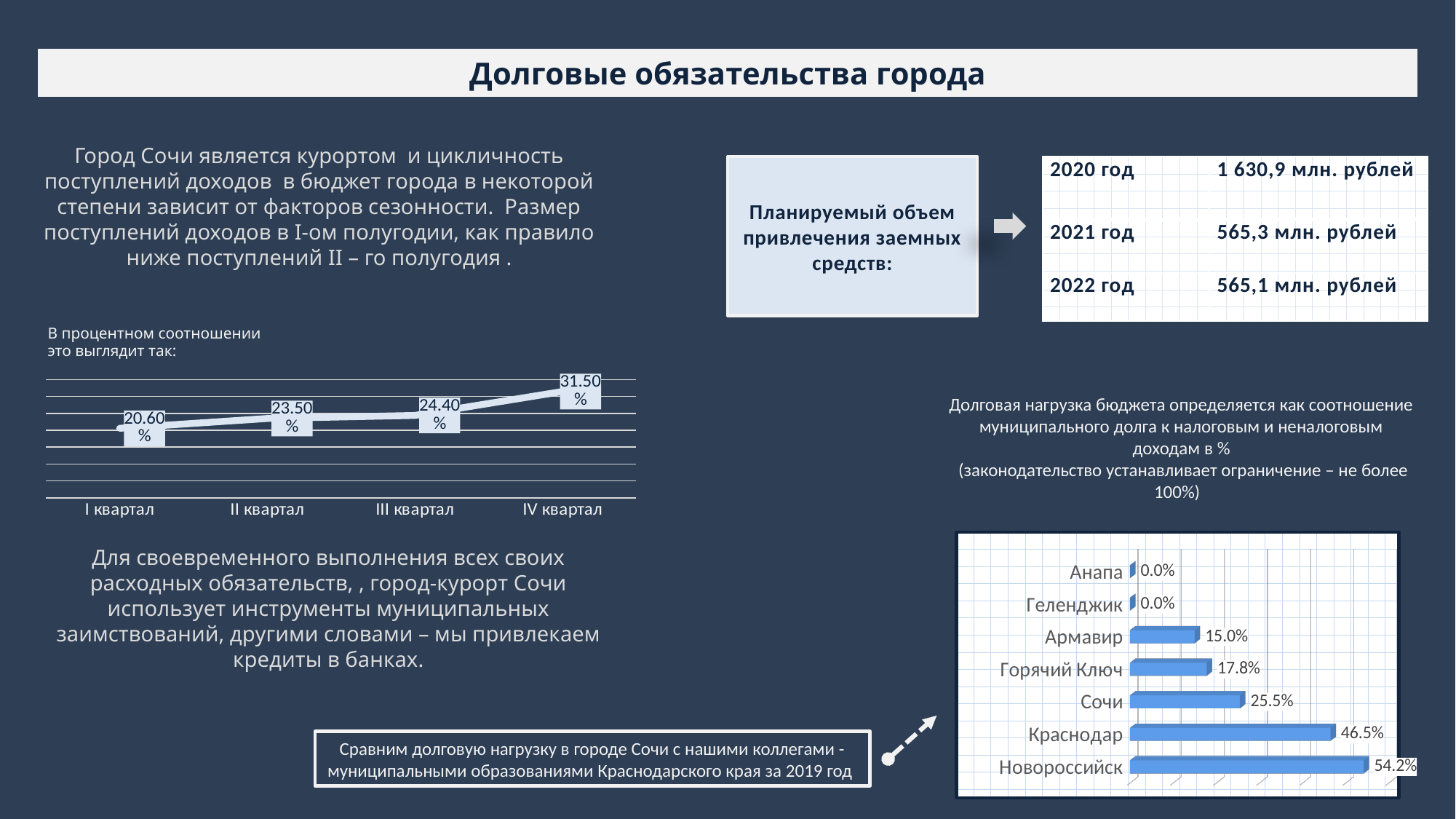
In the bar chart at the bottom right of the slide, which municipality has the highest value? Новороссийск What kind of chart is shown at the bottom right of the slide? bar chart In the bar chart at the bottom right of the slide, what is the difference between the values for Новороссийск and Сочи? 28.7% In the bar chart at the bottom right of the slide, what is the value for Краснодар? 46.5% In the line chart on the left of the slide, which quarter has the highest value? IV квартал In the line chart on the left of the slide, what is the value for I квартал? 20.60% In the line chart on the left of the slide, do the values rise or fall from I квартал to IV квартал? rise In the line chart on the left of the slide, what is the difference between the values for IV квартал and III квартал? 7.10% How many quarters are plotted in the line chart on the left of the slide? 4 In the bar chart at the bottom right of the slide, what is the value for Сочи? 25.5% In the bar chart at the bottom right of the slide, which is larger, the value for Армавир or the value for Горячий Ключ? Горячий Ключ In the line chart on the left of the slide, what is the value for IV квартал? 31.50%